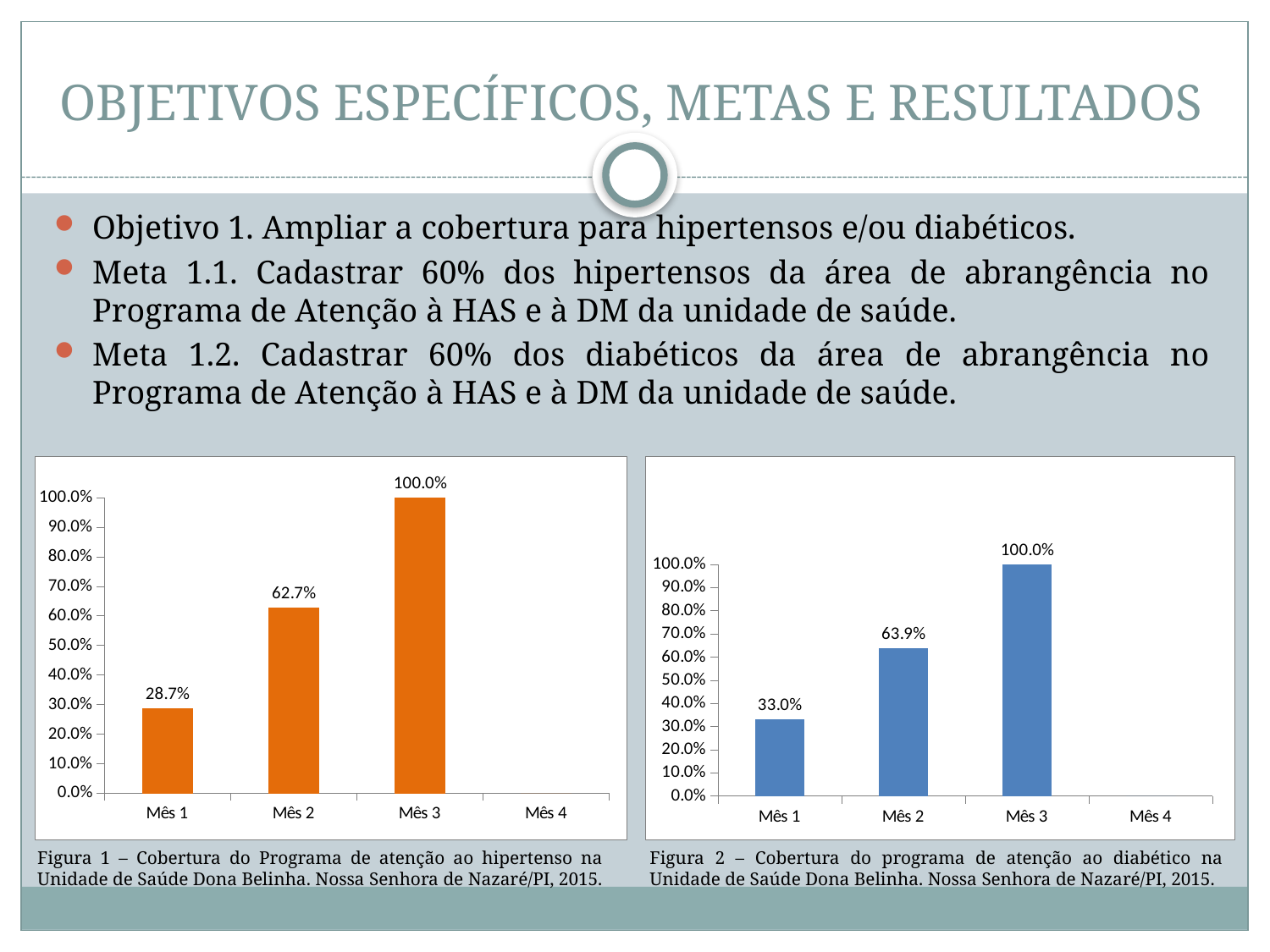
How many month categories are shown on the x axis of the right chart (Figura 2)? 4 In the left chart (Figura 1), what is the value for Mês 2? 62.7% In the left chart (Figura 1), do the values rise or fall from Mês 1 to Mês 3? rise In the left chart (Figura 1), what is the difference between the values for Mês 2 and Mês 1? 34.0% In the left chart (Figura 1), which month has the highest value? Mês 3 In the right chart (Figura 2), what is the difference between the values for Mês 3 and Mês 2? 36.1% In the right chart (Figura 2), what is the value for Mês 2? 63.9% Which is larger: the value for Mês 1 in the left chart (Figura 1) or the value for Mês 1 in the right chart (Figura 2)? Mês 1 in the right chart (Figura 2) What kind of chart is the left chart (Figura 1)? bar chart In the right chart (Figura 2), which month with a plotted bar has the lowest value? Mês 1 In the left chart (Figura 1), what is the value for Mês 1? 28.7% In the right chart (Figura 2), what is the value for Mês 1? 33.0%